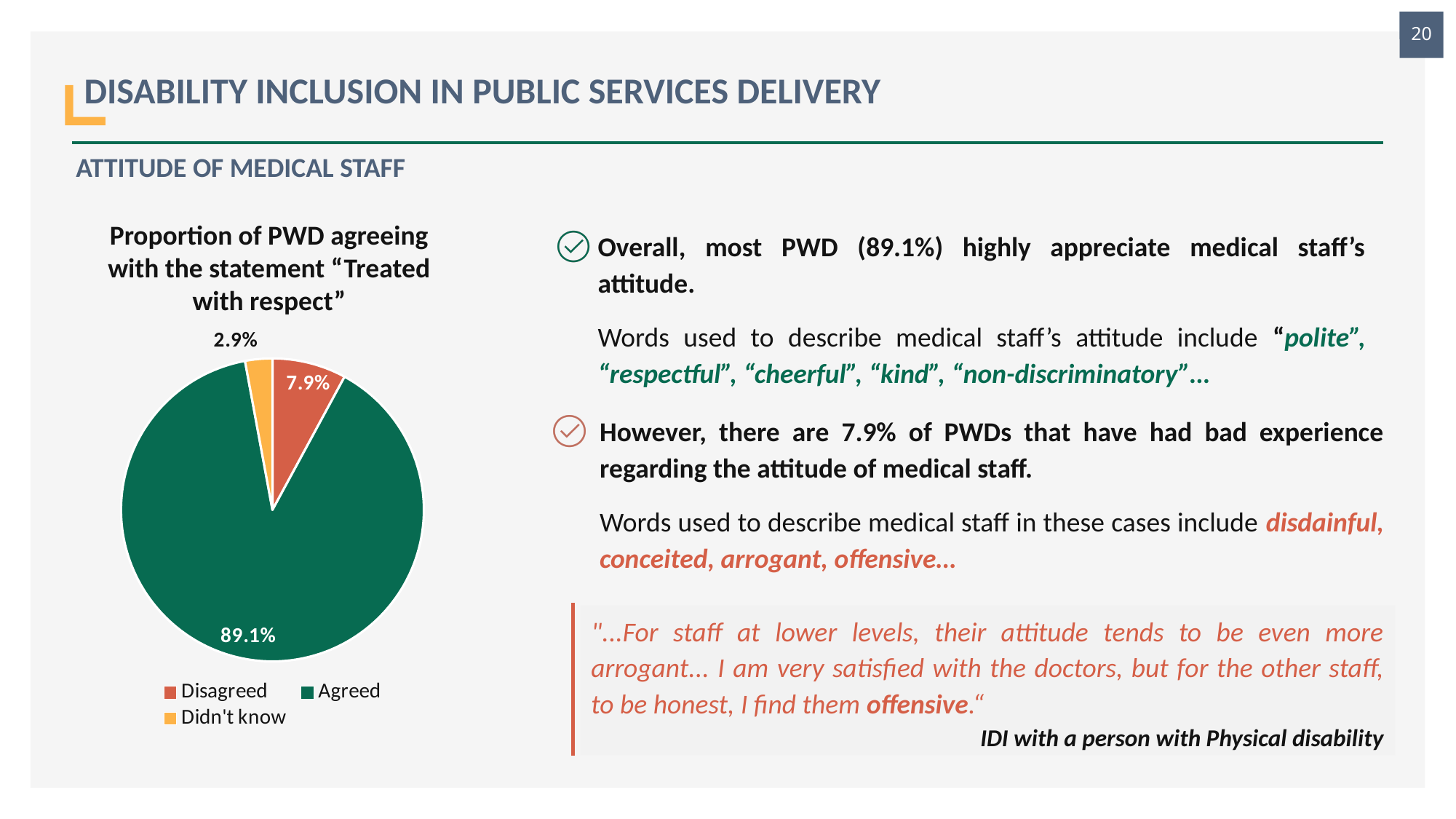
What is the title of the pie chart? Proportion of PWD agreeing with the statement "Treated with respect" What percentage of PWD agreed with the statement "Treated with respect"? 89.1% What colour represents the Agreed category in the pie chart? green What percentage of PWD answered "Didn't know"? 2.9% Which category has the largest share of the pie? Agreed What percentage of PWD disagreed with the statement "Treated with respect"? 7.9% How many entries does the legend list? 3 What is the difference between the Agreed and Disagreed shares? 81.2% Which category has the smallest share of the pie? Didn't know Which is larger, the Disagreed share or the Didn't know share? Disagreed How many categories does the pie chart show? 3 What type of chart is shown on the slide? pie chart